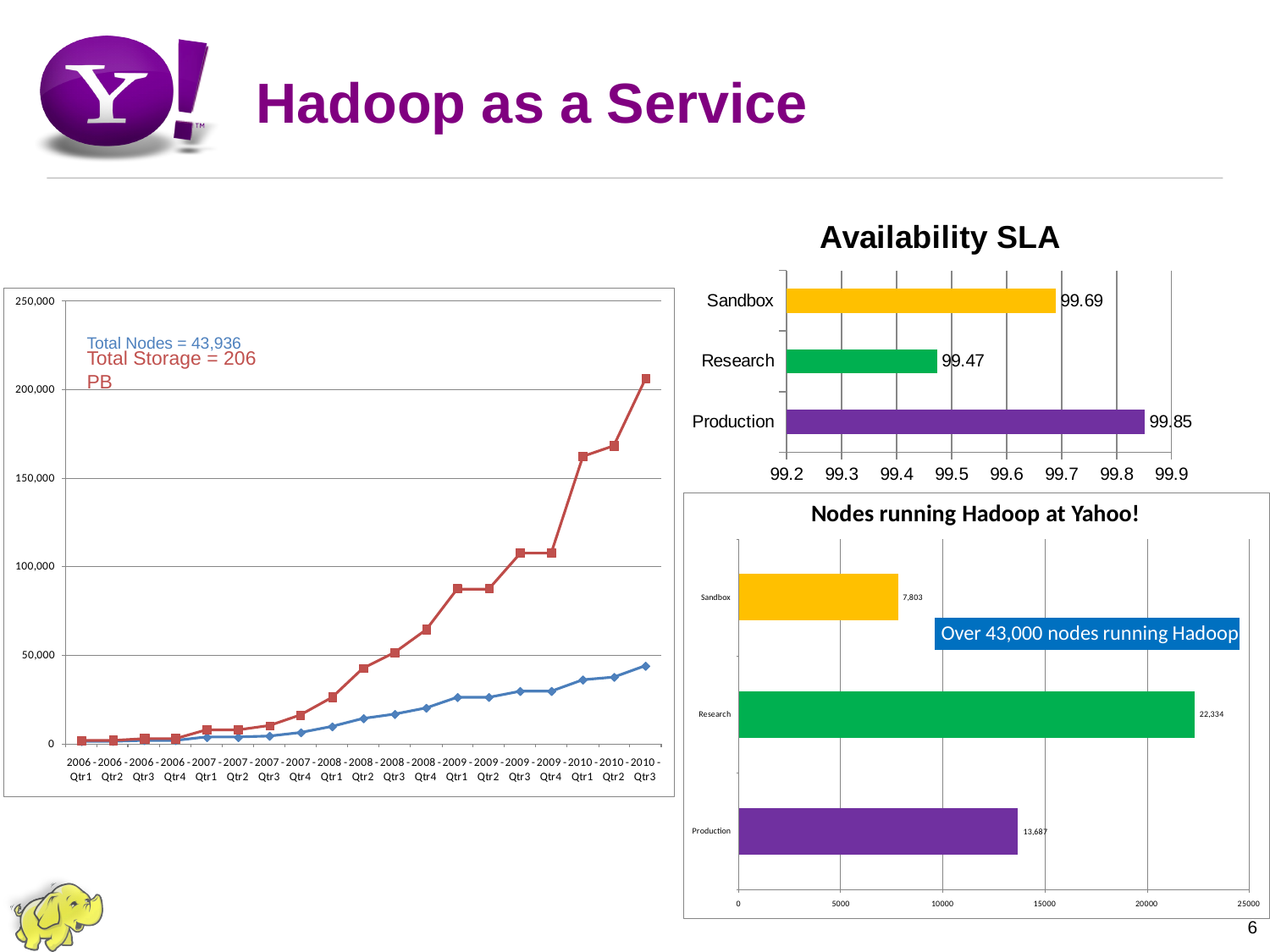
In the Nodes running Hadoop at Yahoo! chart, what is the difference between the Research and Production values? 8,647 In the Nodes running Hadoop at Yahoo! chart, which category has the most nodes? Research In the line chart on the left, does the red line rise or fall from 2006 Qtr1 to 2010 Qtr3? rise What kind of chart is the chart on the left of the slide? line chart In the Availability SLA chart, what is the value for Production? 99.85 In the line chart on the left, is the value of the blue line at 2010 Qtr3 greater or less than 50,000? less In the Availability SLA chart, what is the difference between the Production and Research values? 0.38 In the Availability SLA chart, which category has the highest value? Production In the Availability SLA chart, what is the value for Research? 99.47 In the Availability SLA chart, which category has the lowest value? Research In the Nodes running Hadoop at Yahoo! chart, is the value for Production larger or smaller than the value for Sandbox? larger In the Nodes running Hadoop at Yahoo! chart, what is the value for Sandbox? 7,803